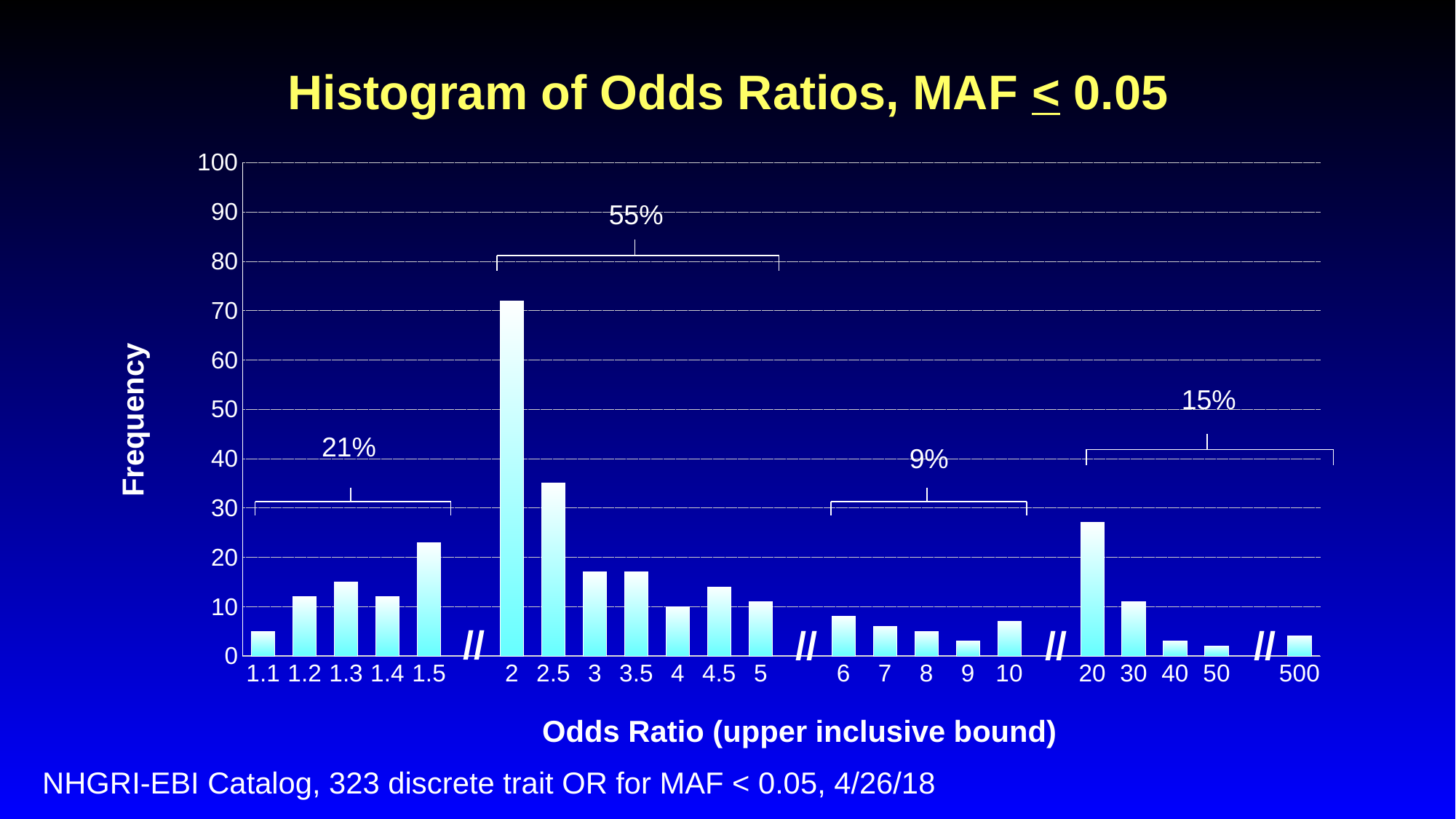
What percentage is labelled above the bracket spanning odds ratios 20 to 500? 15% Is the frequency for odds ratio 1.1 greater or less than 10? less Is the frequency for odds ratio 2.5 greater or less than 30? greater Is the frequency for odds ratio 2 greater or less than 70? greater Which has the higher frequency, odds ratio 20 or odds ratio 30? 20 Which odds ratio category has the highest frequency? 2 What is the title of the chart? Histogram of Odds Ratios, MAF ≤ 0.05 How many odds ratio categories are shown on the x axis? 22 What kind of chart is shown on the slide? bar chart Which has the higher frequency, odds ratio 1.5 or odds ratio 1.3? 1.5 What percentage is labelled above the bracket spanning odds ratios 2 to 5? 55%